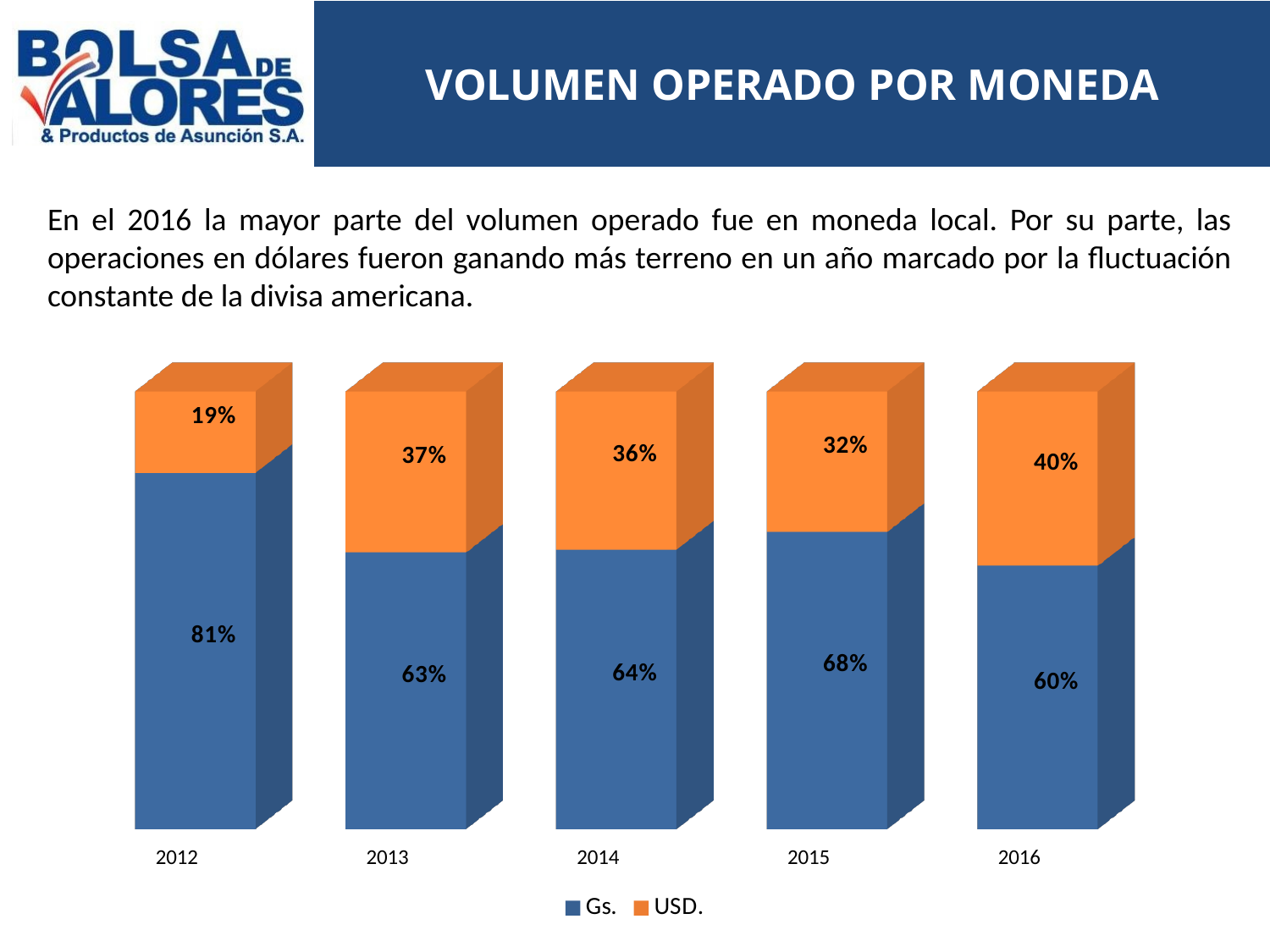
In which year is the USD. share the highest? 2016 Which is larger, the USD. share in 2014 or the USD. share in 2015? 2014 How many years are shown on the x axis of the chart? 5 What is the USD. share of the volume operated in 2016? 40% What is the difference between the Gs. share in 2012 and the Gs. share in 2016? 21% What is the USD. share of the volume operated in 2013? 37% In which year is the USD. share the lowest? 2012 What is the Gs. share of the volume operated in 2015? 68% In which year is the Gs. share the highest? 2012 What kind of chart is shown on the slide? Stacked bar chart What is the Gs. share of the volume operated in 2012? 81% How many series does the legend list? 2